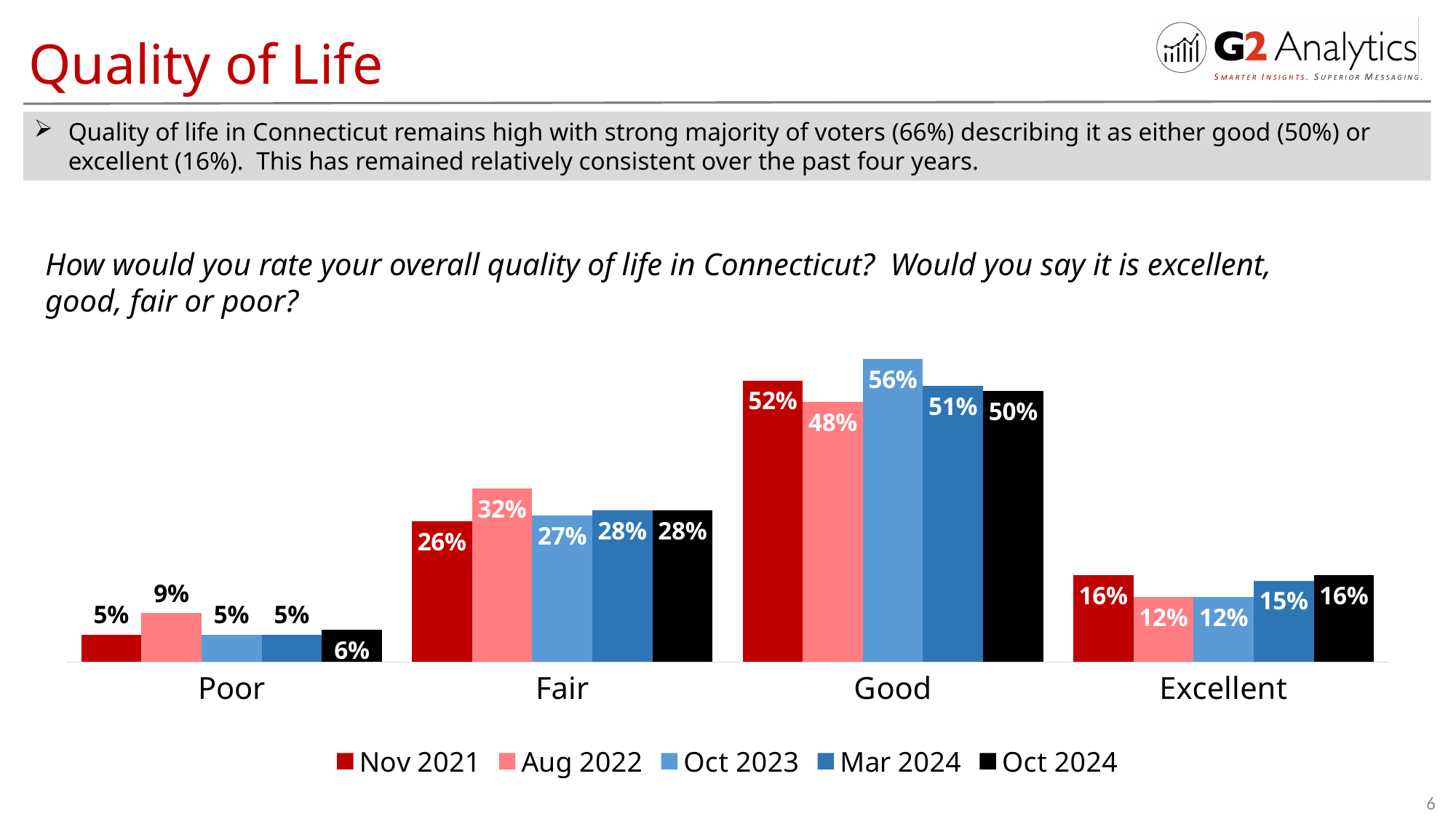
How many survey waves does the legend list? 5 What percentage of voters rated quality of life as Excellent in Mar 2024? 15% Which is larger, the Fair rating in Aug 2022 or the Fair rating in Oct 2023? Aug 2022 Which category has the lowest value in Oct 2024? Poor What percentage of voters rated quality of life as Poor in Aug 2022? 9% What percentage of voters rated quality of life as Fair in Nov 2021? 26% What is the difference between the Good rating in Oct 2023 and in Aug 2022? 8 percentage points In which survey wave was the Good rating highest? Oct 2023 How many response categories are shown on the x axis? 4 What percentage of voters rated quality of life as Good in Oct 2024? 50% What kind of chart is shown on the slide? Bar chart What colour represents the Oct 2024 series? Black